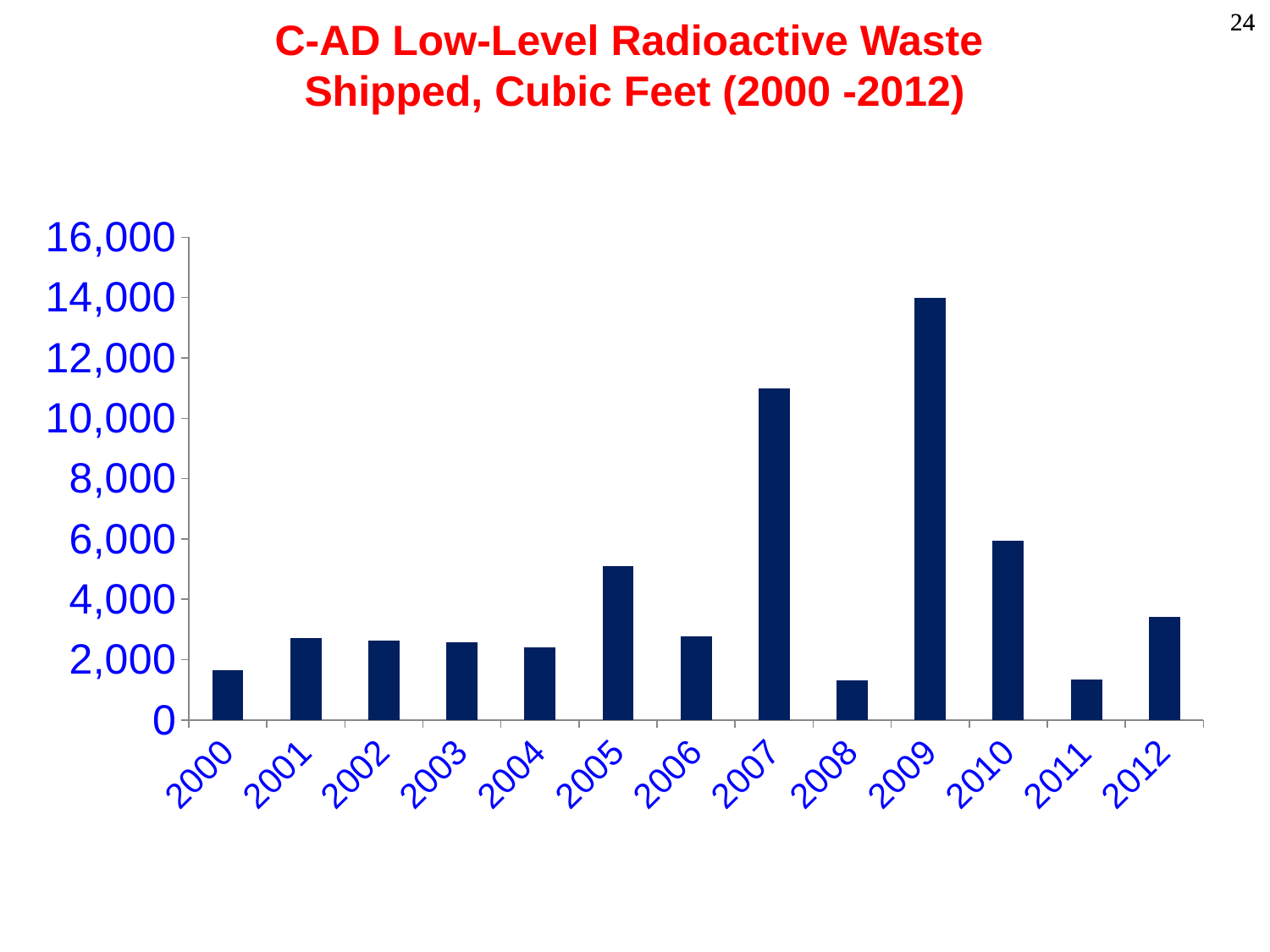
What is the title of the chart? C-AD Low-Level Radioactive Waste Shipped, Cubic Feet (2000 -2012) Which year has the larger value, 2007 or 2010? 2007 Is the value for 2007 greater or less than 10,000? greater Is the value for 2008 greater or less than 2,000? less Which year has the larger value, 2005 or 2012? 2005 Is the value for 2009 greater or less than 12,000? greater What kind of chart is shown on the slide? bar chart Which year has the highest volume of low-level radioactive waste shipped? 2009 Does the value rise or fall from 2007 to 2008? fall How many years are plotted on the chart? 13